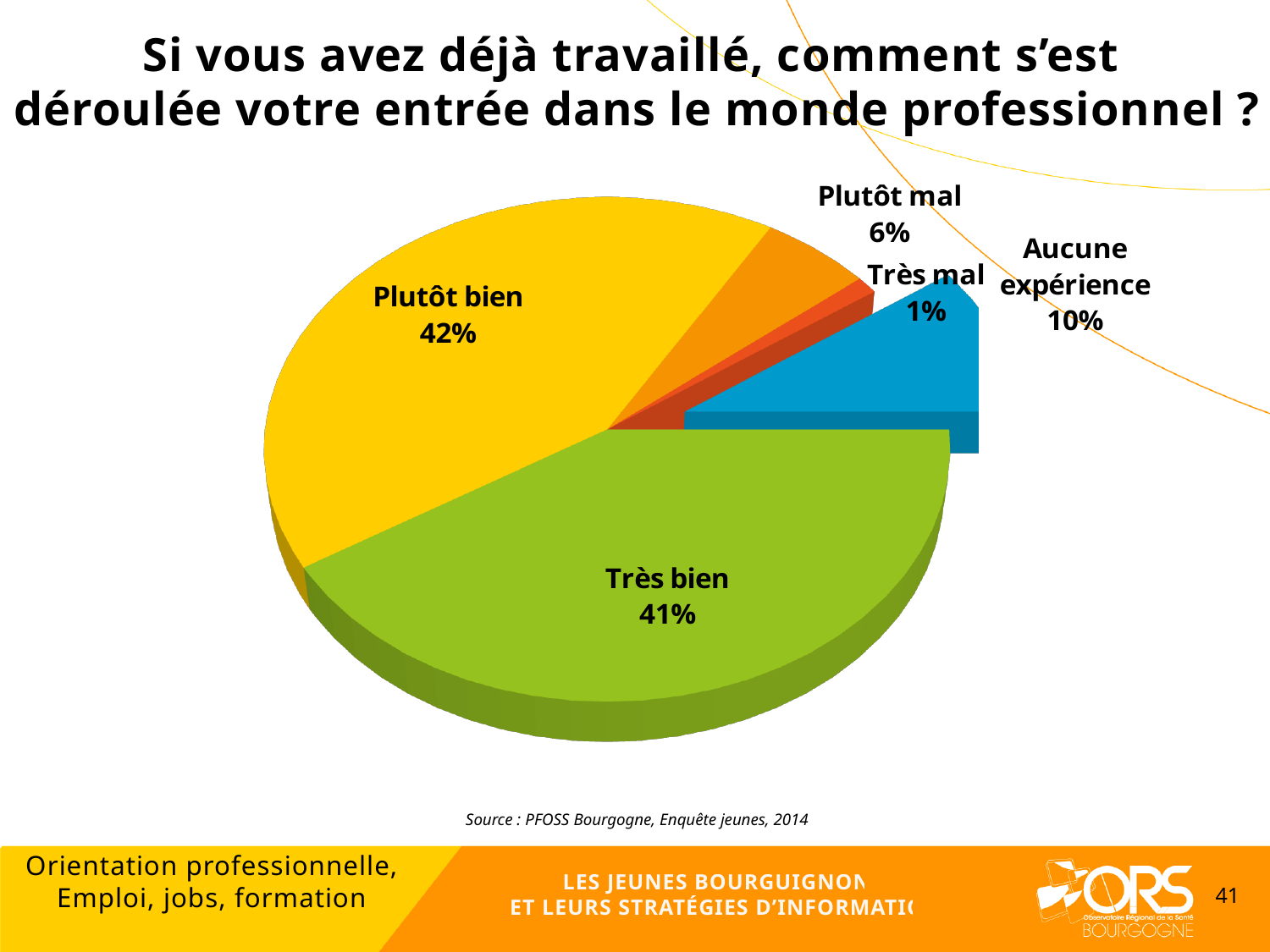
What percentage is shown for "Plutôt mal"? 6% What percentage is shown for "Très mal"? 1% What is the source cited below the chart? PFOSS Bourgogne, Enquête jeunes, 2014 What percentage of respondents answered "Très bien"? 41% Which category has the smallest slice of the pie? Très mal Which is larger, the share for "Aucune expérience" or the share for "Plutôt mal"? Aucune expérience How many categories (slices) does the pie chart have? 5 What percentage of respondents answered "Plutôt bien"? 42% What is the difference in percentage points between "Aucune expérience" and "Plutôt mal"? 4 percentage points What share of the pie is "Aucune expérience"? 10% Which category has the largest slice of the pie? Plutôt bien What kind of chart is shown on the slide? pie chart